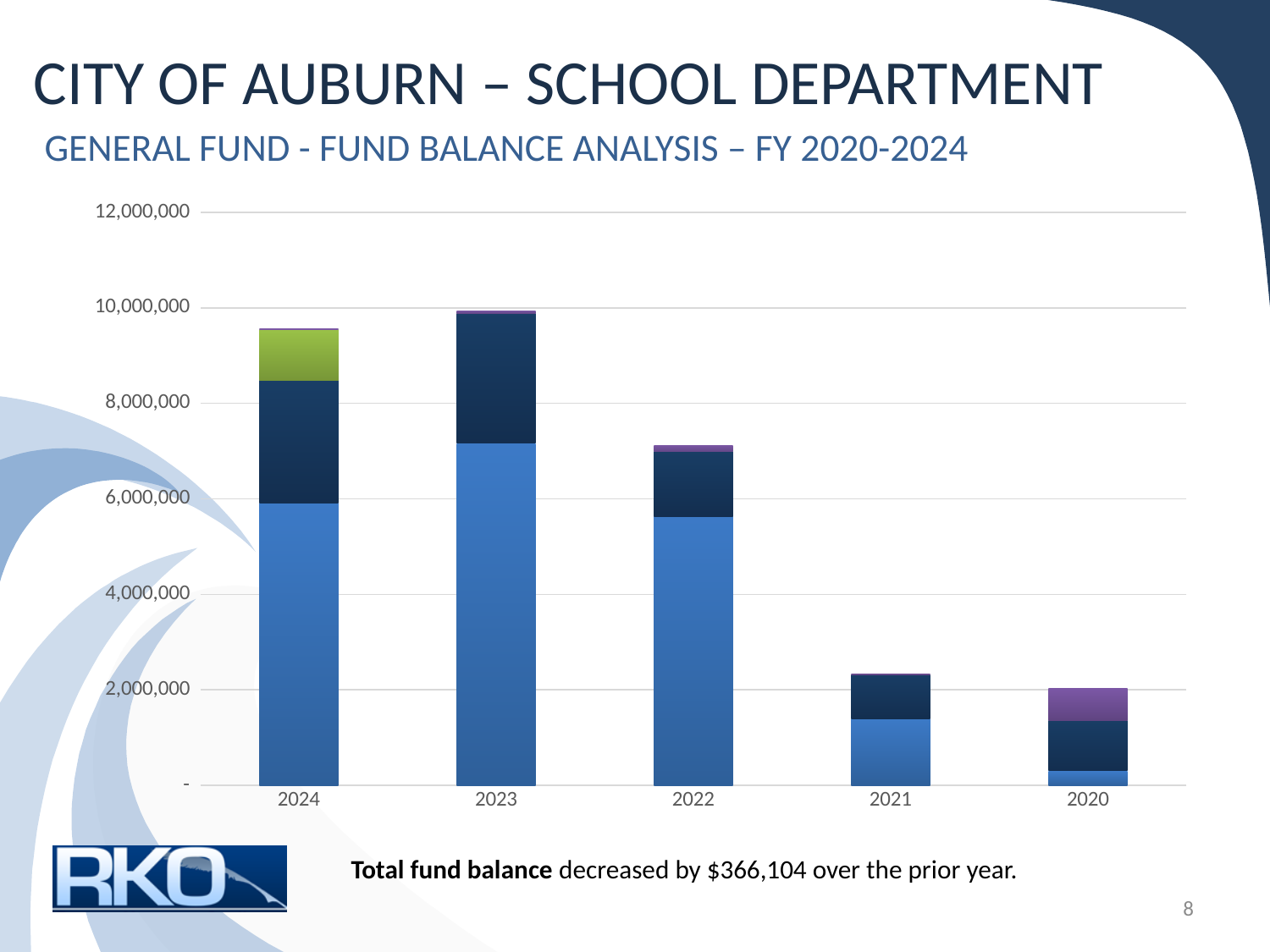
What is the highest value labelled on the y axis of the chart? 12,000,000 Which fiscal year has the shortest total bar in the chart? 2020 What kind of chart is shown on the slide? Stacked bar chart Is the total bar for 2022 greater or less than 6,000,000? greater According to the note below the chart, by how much did the total fund balance decrease over the prior year? $366,104 Is the total bar for 2021 greater or less than 4,000,000? less Which has the larger total bar, 2024 or 2022? 2024 Which has the larger total bar, 2022 or 2021? 2022 Which fiscal year has the tallest total bar in the chart? 2023 How many fiscal years are shown on the x axis of the chart? 5 Is the total bar for 2024 greater or less than 8,000,000? greater